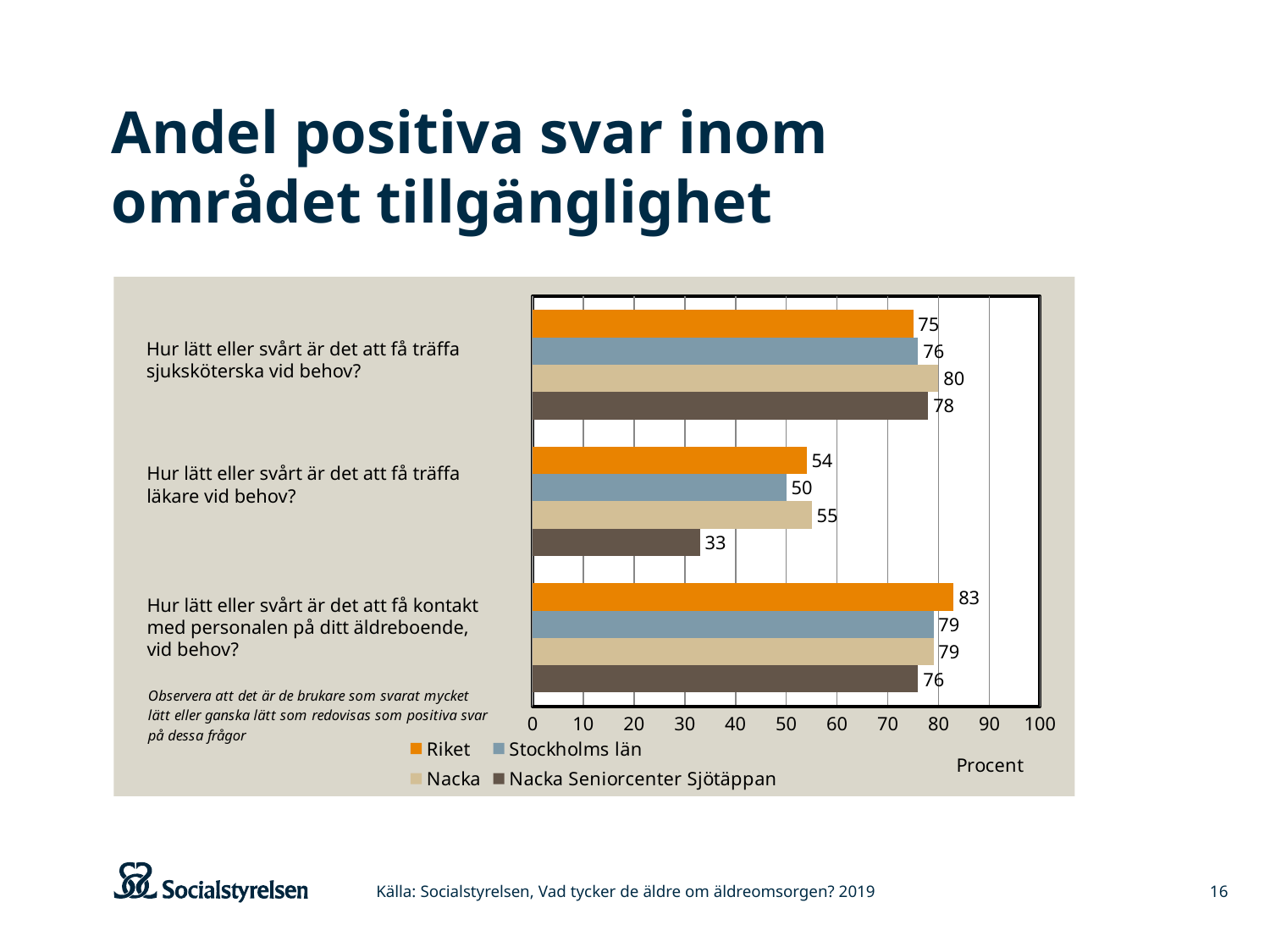
Is the value for Stockholms län on the question "Hur lätt eller svårt är det att få träffa läkare vid behov?" greater or less than 60? less How many series does the legend list? 4 What is the difference between Nacka and Nacka Seniorcenter Sjötäppan on the question "Hur lätt eller svårt är det att få träffa läkare vid behov?"? 22 Which is larger on the question "Hur lätt eller svårt är det att få träffa sjuksköterska vid behov?": Riket or Nacka? Nacka Which series has the highest value on the question "Hur lätt eller svårt är det att få kontakt med personalen på ditt äldreboende, vid behov?"? Riket What is the label on the horizontal axis of the chart? Procent What is the value for Nacka on the question "Hur lätt eller svårt är det att få träffa sjuksköterska vid behov?"? 80 How many questions (categories) are shown on the chart? 3 Which series has the lowest value on the question "Hur lätt eller svårt är det att få träffa läkare vid behov?"? Nacka Seniorcenter Sjötäppan What kind of chart is shown on the slide? Bar chart What is the value for Riket on the question "Hur lätt eller svårt är det att få kontakt med personalen på ditt äldreboende, vid behov?"? 83 What is the value for Nacka Seniorcenter Sjötäppan on the question "Hur lätt eller svårt är det att få träffa läkare vid behov?"? 33